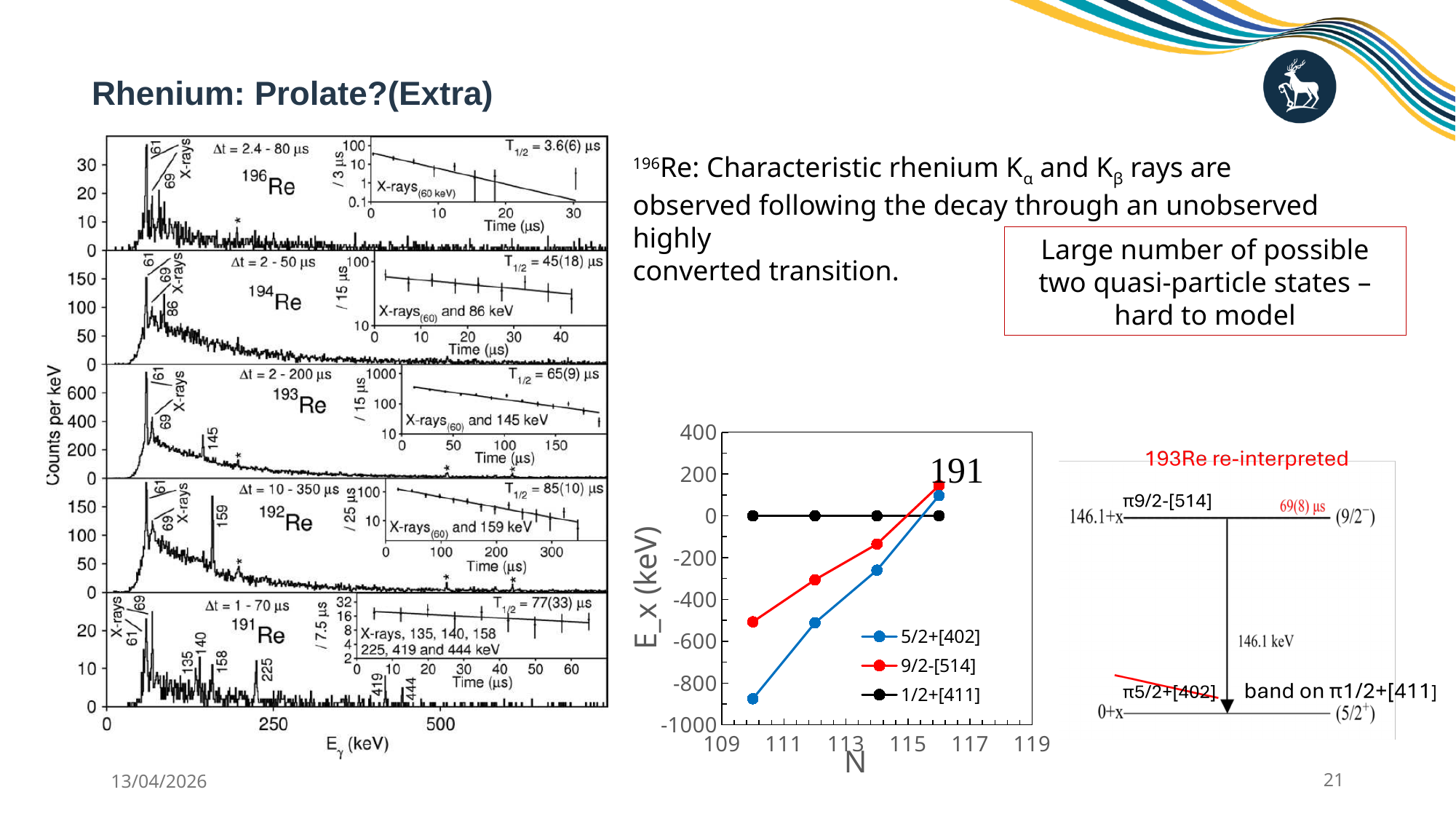
How many data points does the 5/2+[402] series have in the E_x versus N chart? 4 What kind of chart is the E_x versus N chart in the middle of the slide? line chart In the E_x versus N chart, is the value of the 9/2-[514] series at N = 110 greater or less than -400? less In the E_x versus N chart, what is the E_x value of the 1/2+[411] series at N = 112? 0 In the E_x versus N chart, which series has the lowest value at N = 110? 5/2+[402] What is the label of the y axis of the E_x versus N chart? E_x (keV) In the E_x versus N chart, do the values of the 5/2+[402] series rise or fall as N increases? rise In the E_x versus N chart, which series has the higher value at N = 110, 5/2+[402] or 9/2-[514]? 9/2-[514] In the E_x versus N chart, is the value of the 5/2+[402] series at N = 116 greater or less than 0? greater How many series does the legend of the E_x versus N chart list? 3 In the E_x versus N chart, is the value of the 5/2+[402] series at N = 110 greater or less than -800? less What colour is the 9/2-[514] series in the E_x versus N chart? red